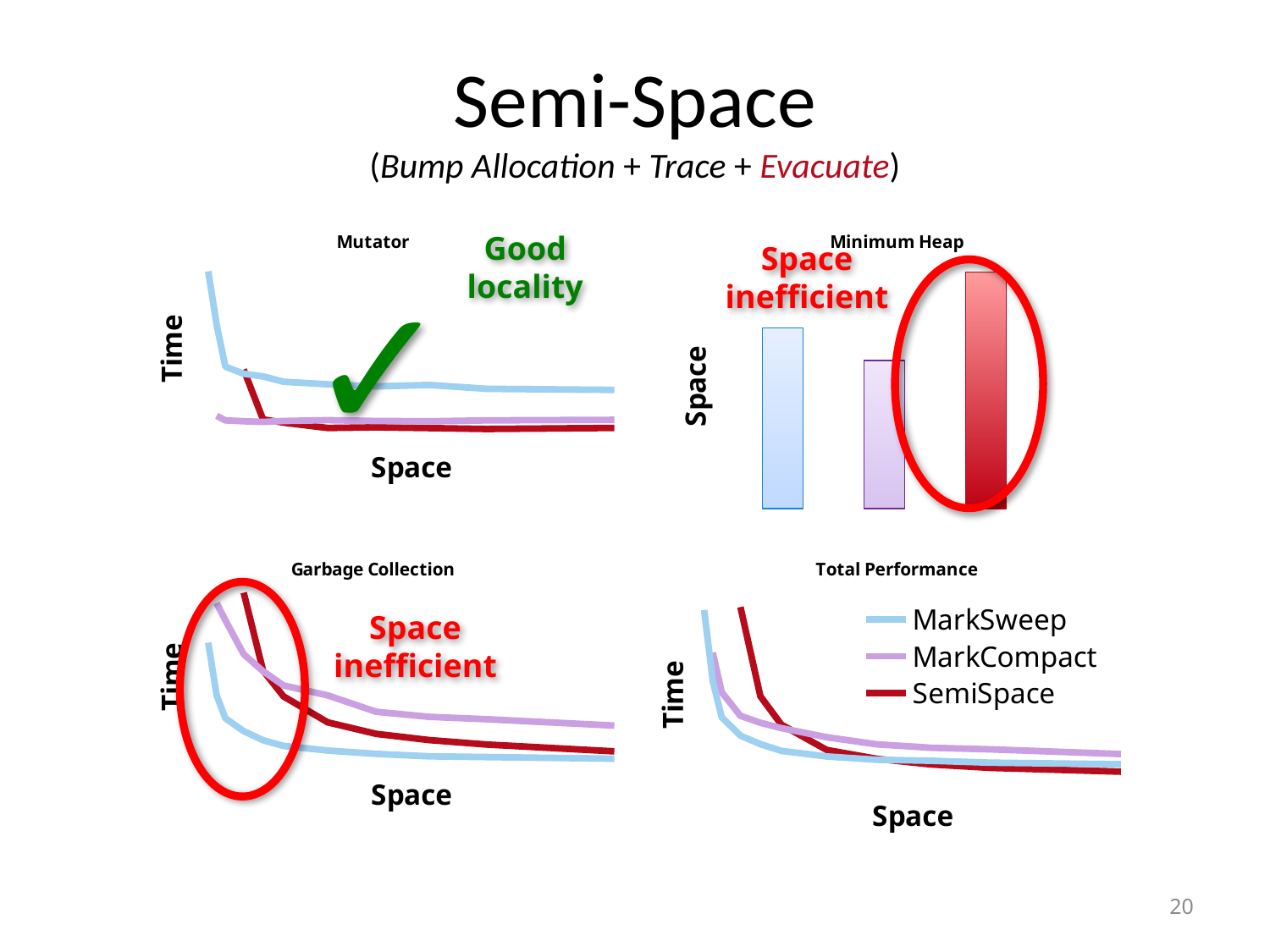
In the "Mutator" chart, does the MarkSweep line rise or fall as Space increases? fall What kind of chart is the "Total Performance" chart? line chart What kind of chart is the "Minimum Heap" chart? bar chart How many bars are plotted in the "Minimum Heap" chart? 3 In the "Garbage Collection" chart, does the SemiSpace line rise or fall as Space increases? fall In the "Minimum Heap" chart, is the SemiSpace bar taller or shorter than the MarkSweep bar? taller In the "Minimum Heap" chart, which series has the tallest bar? SemiSpace How many series does the legend on the "Total Performance" chart list? 3 What is the y-axis label of the "Minimum Heap" chart? Space Which series is shown in red in the "Total Performance" chart legend? SemiSpace In the "Minimum Heap" chart, which series has the shortest bar? MarkCompact